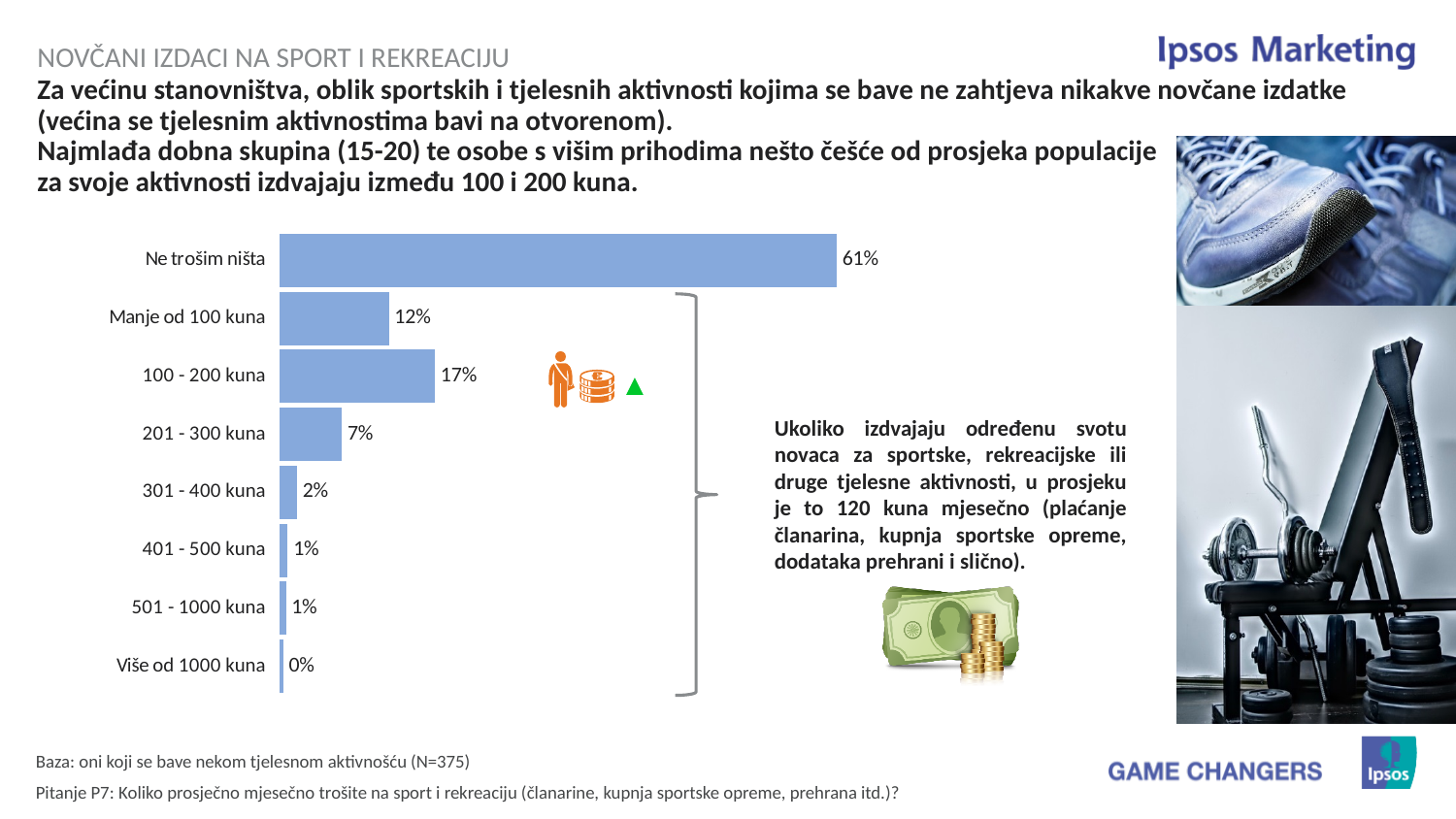
What is the difference between the values for "100 - 200 kuna" and "Manje od 100 kuna"? 5% What is the value for "100 - 200 kuna"? 17% What is the value for "Ne trošim ništa"? 61% Which category has the lowest value? Više od 1000 kuna What is the value for "Više od 1000 kuna"? 0% Which is larger, the value for "201 - 300 kuna" or the value for "301 - 400 kuna"? 201 - 300 kuna Which category has the highest value? Ne trošim ništa What is the difference between the values for "Ne trošim ništa" and "100 - 200 kuna"? 44% What is the value for "Manje od 100 kuna"? 12% What kind of chart is shown on the slide? Bar chart What is the value for "201 - 300 kuna"? 7% How many categories are shown in the chart? 8